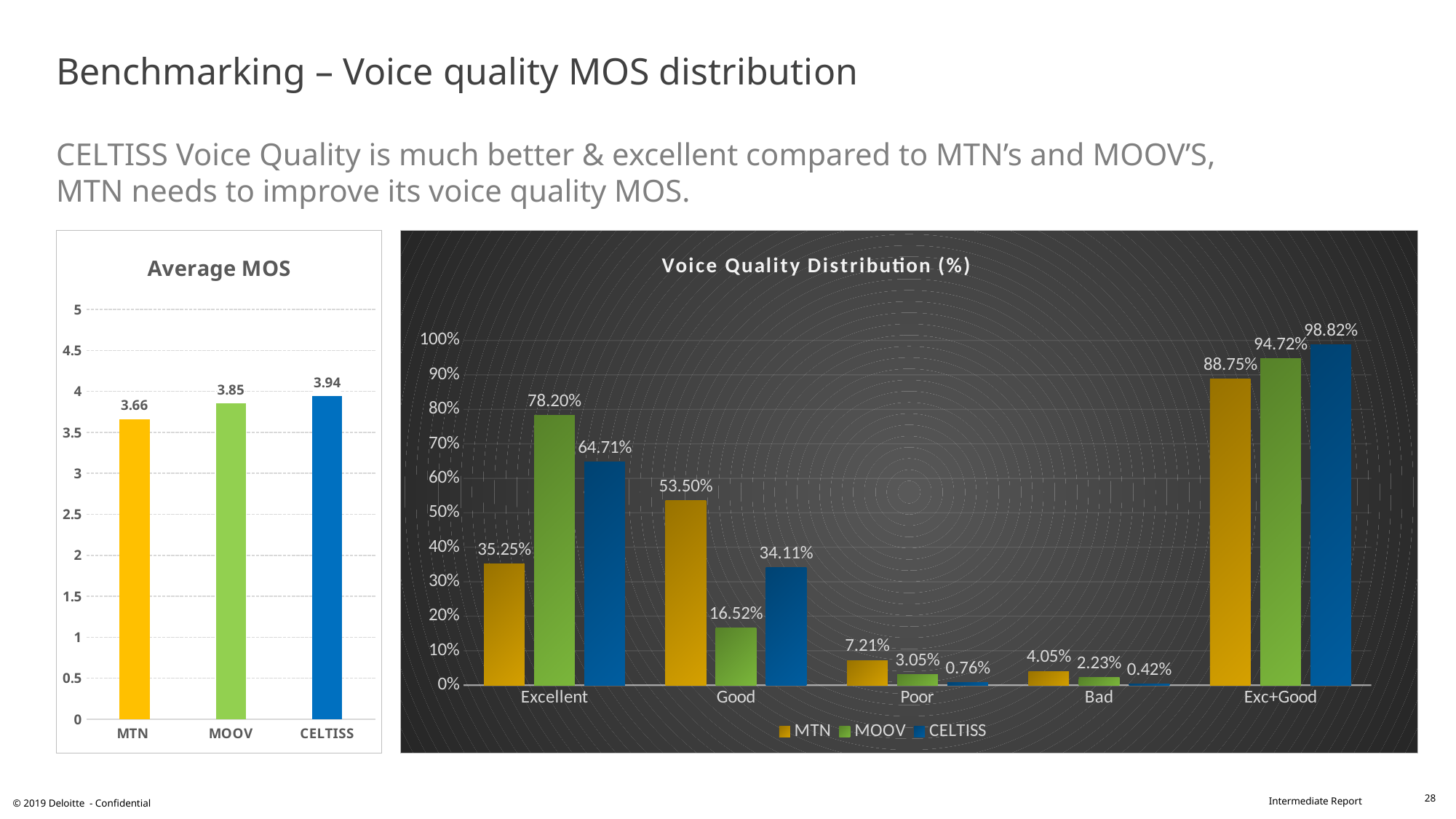
In the Average MOS chart, what is the difference between the CELTISS and MTN values? 0.28 In the Voice Quality Distribution (%) chart, how many series does the legend list? 3 In the Average MOS chart, which operator has the highest average MOS? CELTISS In the Voice Quality Distribution (%) chart, which is larger for Exc+Good: MTN or CELTISS? CELTISS In the Voice Quality Distribution (%) chart, which operator has the highest value for Good? MTN In the Average MOS chart, what is the value for MOOV? 3.85 What kind of chart is the Voice Quality Distribution (%) chart? Bar chart In the Voice Quality Distribution (%) chart, what is the difference between the CELTISS and MOOV values for Exc+Good? 4.10% In the Voice Quality Distribution (%) chart, what is the CELTISS value for Poor? 0.76% In the Average MOS chart, how many operators are shown on the x axis? 3 In the Average MOS chart, which operator has the lowest average MOS? MTN In the Voice Quality Distribution (%) chart, what is the MOOV value for Excellent? 78.20%